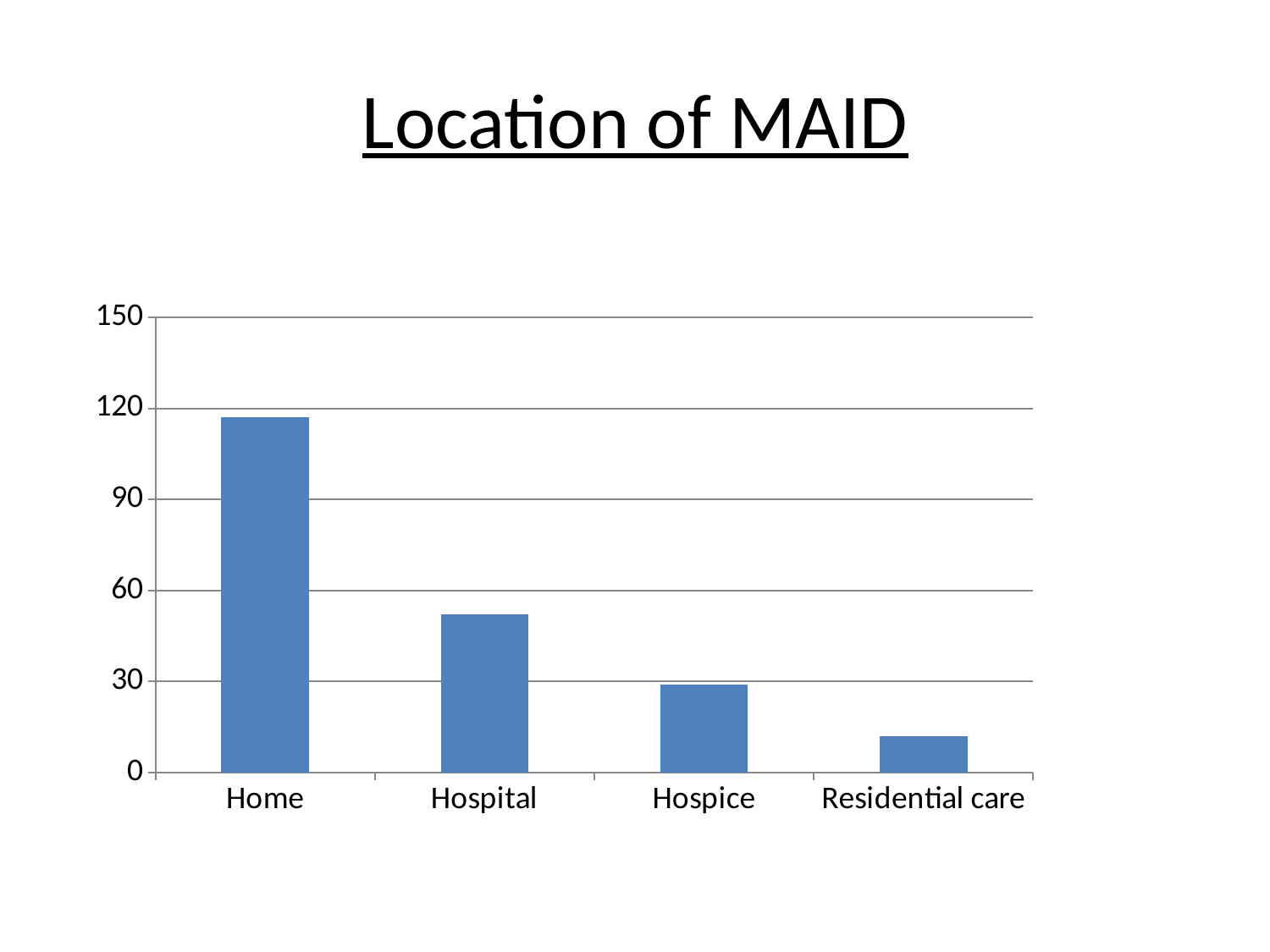
Which is larger, the value for Hospital or the value for Hospice? Hospital Which is larger, the value for Home or the value for Residential care? Home Which location has the highest value? Home Is the value for Home greater or less than 90? greater Do the values rise or fall from left to right across the categories? fall What is the title of the slide? Location of MAID Is the value for Residential care greater or less than 30? less How many categories are shown on the x axis? 4 Is the value for Hospital greater or less than 60? less What kind of chart is shown on the slide? bar chart Which location has the lowest value? Residential care